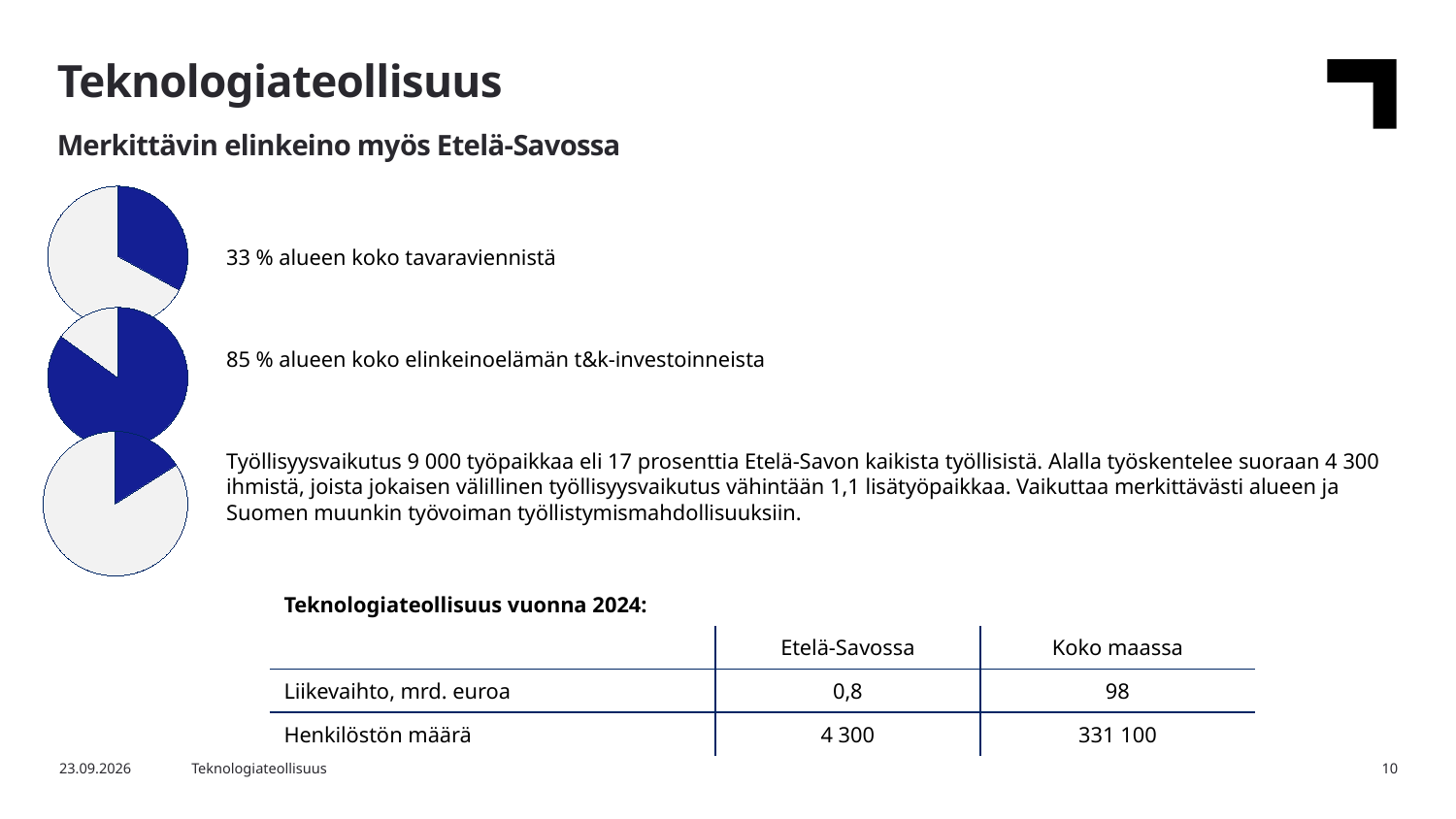
Which of the three pie charts has the largest blue slice? The middle pie chart (85 % of R&D investments) Is the blue slice in the top pie chart greater or less than half of the pie? Less In the middle pie chart, what share of the region's business R&D investments (t&k-investoinnit) does the blue slice represent? 85 % Which of the three pie charts has the smallest blue slice? The bottom pie chart (employment share) What kind of charts are shown on the left side of the slide? Pie charts How many slices does each pie chart have? 2 What two colours are used in the pie charts? Dark blue and light grey How many pie charts are on the slide? 3 Is the blue slice in the top pie chart larger or smaller than the blue slice in the bottom pie chart? Larger In the top pie chart, what share of the region's total goods exports (tavaravienti) does the blue slice represent? 33 % What is the difference between the blue share in the middle pie chart (85 %) and the blue share in the top pie chart (33 %)? 52 percentage points Is the blue slice in the middle pie chart greater or less than half of the pie? Greater